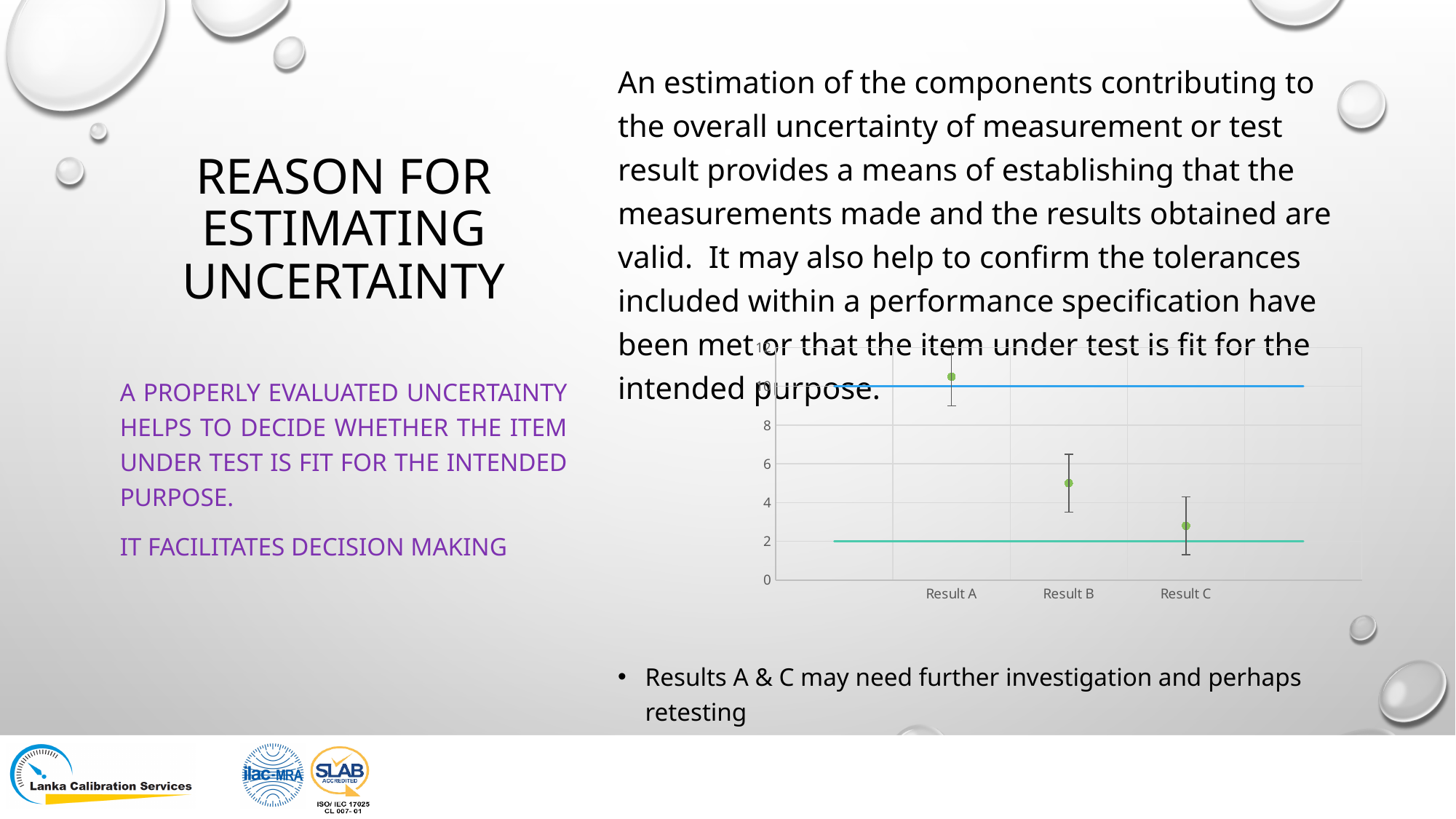
At what value on the y axis is the upper horizontal line drawn? 10 Which is larger, the value for Result A or the value for Result B? Result A Which result has the highest plotted value? Result A How many results are plotted on the chart? 3 Is the value for Result C greater or less than 4? less What is the highest value shown on the y axis? 12 At what value on the y axis is the lower horizontal line drawn? 2 Is the value for Result B greater or less than 4? greater Do the plotted values rise or fall from Result A to Result C? fall Is the value for Result B greater or less than 8? less Which result has the lowest plotted value? Result C